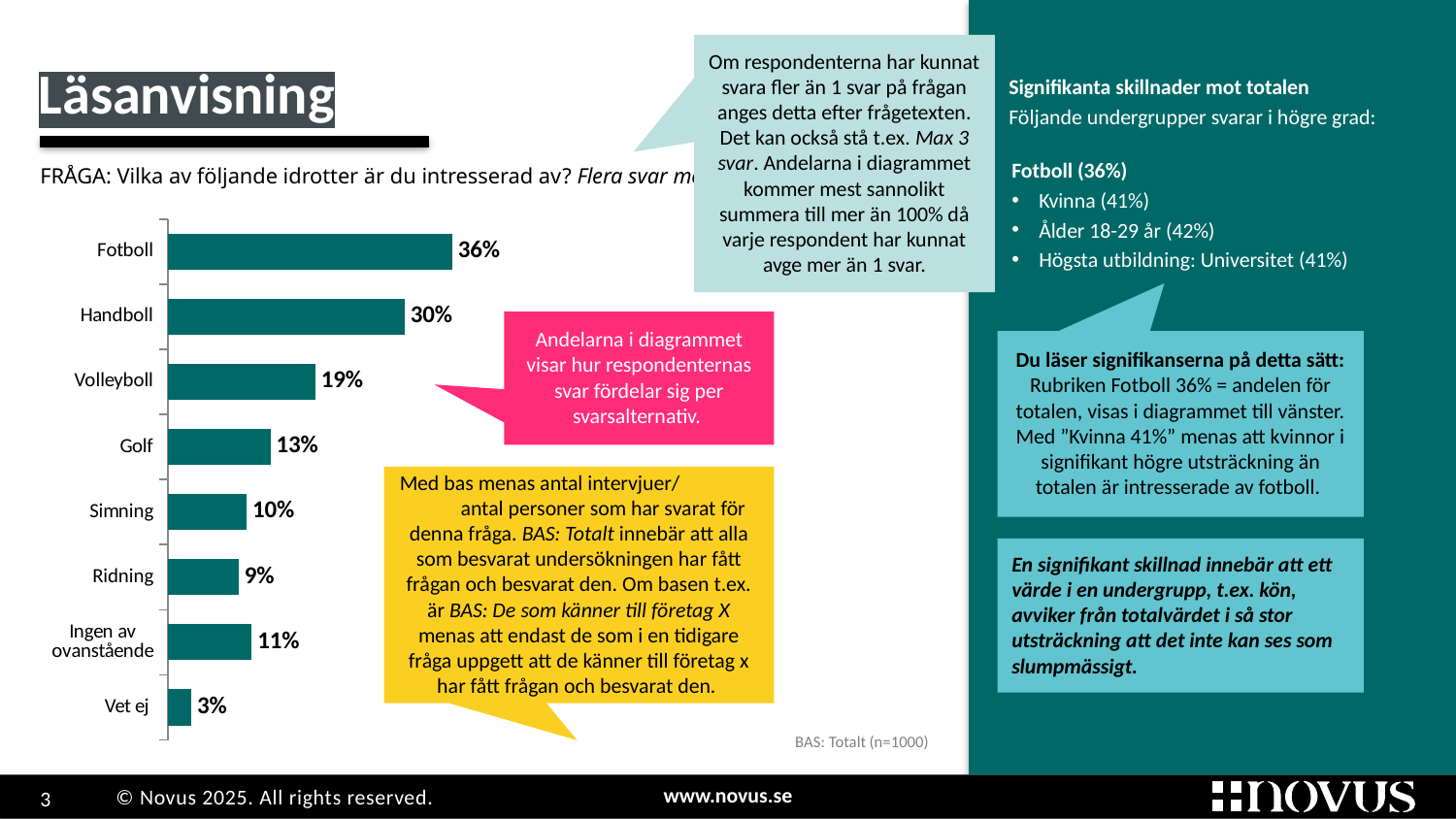
Which category has the lowest value in the bar chart? Vet ej How many categories are shown in the bar chart? 8 Which category has the highest value in the bar chart? Fotboll What is the value for Fotboll in the bar chart? 36% What kind of chart is shown on the slide? Bar chart Which has a larger value, Simning or Ridning? Simning What is the value for Golf in the bar chart? 13% What is the value for Handboll in the bar chart? 30% Which has a larger value, Ingen av ovanstående or Simning? Ingen av ovanstående What is the value for Ingen av ovanstående in the bar chart? 11% What is the difference between the values for Volleyboll and Golf? 6 percentage points What is the difference between the values for Fotboll and Handboll? 6 percentage points